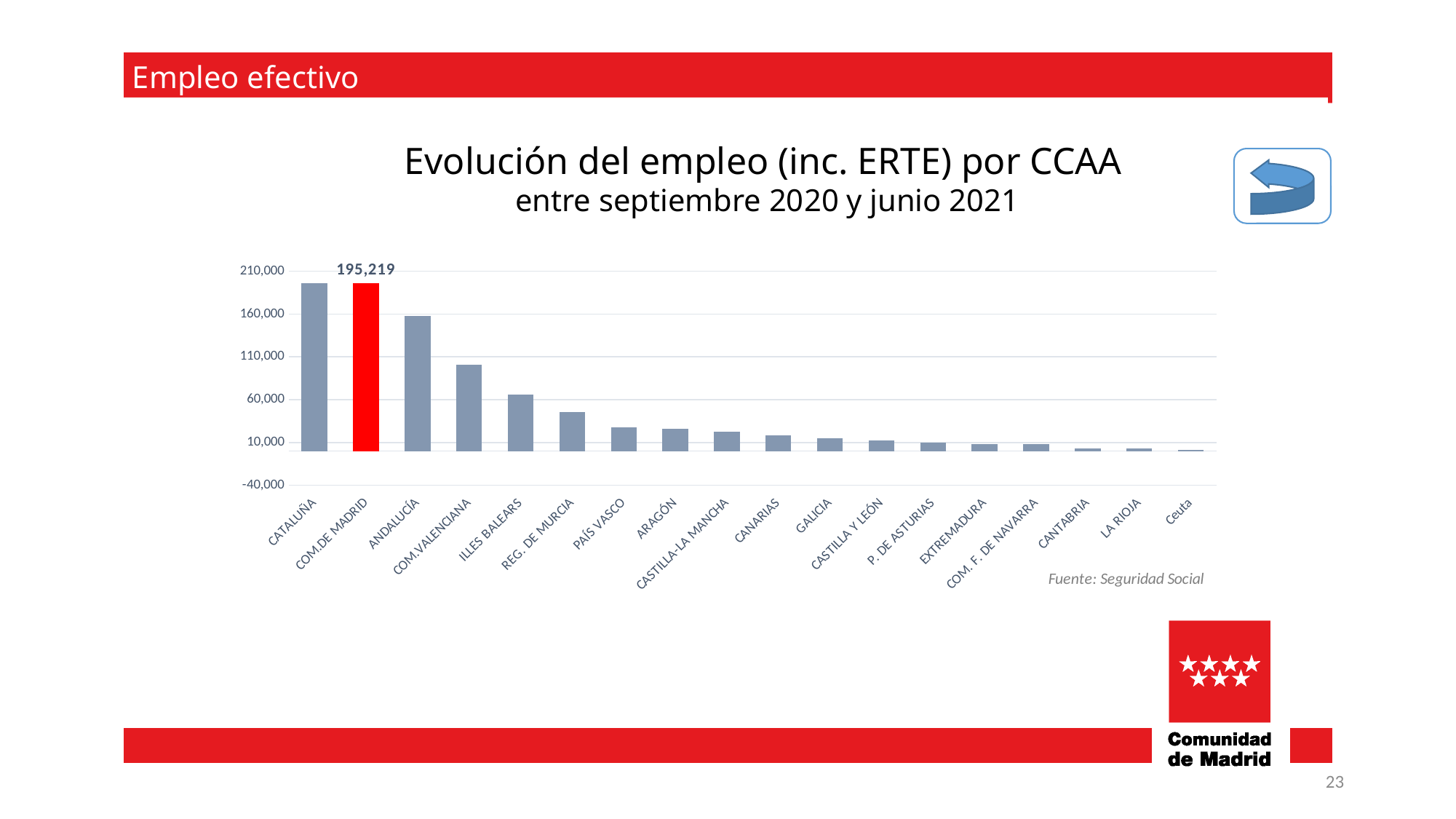
Is the value for REG. DE MURCIA greater or less than 60,000? less Is the value for CATALUÑA greater or less than 160,000? greater Which has the larger value, ILLES BALEARS or REG. DE MURCIA? ILLES BALEARS Which has the larger value, ANDALUCÍA or COM.VALENCIANA? ANDALUCÍA Do the bar values generally rise or fall moving from left to right along the x axis? fall Is the value for PAÍS VASCO greater or less than 10,000? greater What is the source cited below the chart? Seguridad Social What value is labelled on the bar for COM.DE MADRID? 195,219 Which region's bar is highlighted in red? COM.DE MADRID How many regions (categories) are shown on the x axis of the chart? 18 What kind of chart is shown on the slide? Bar chart